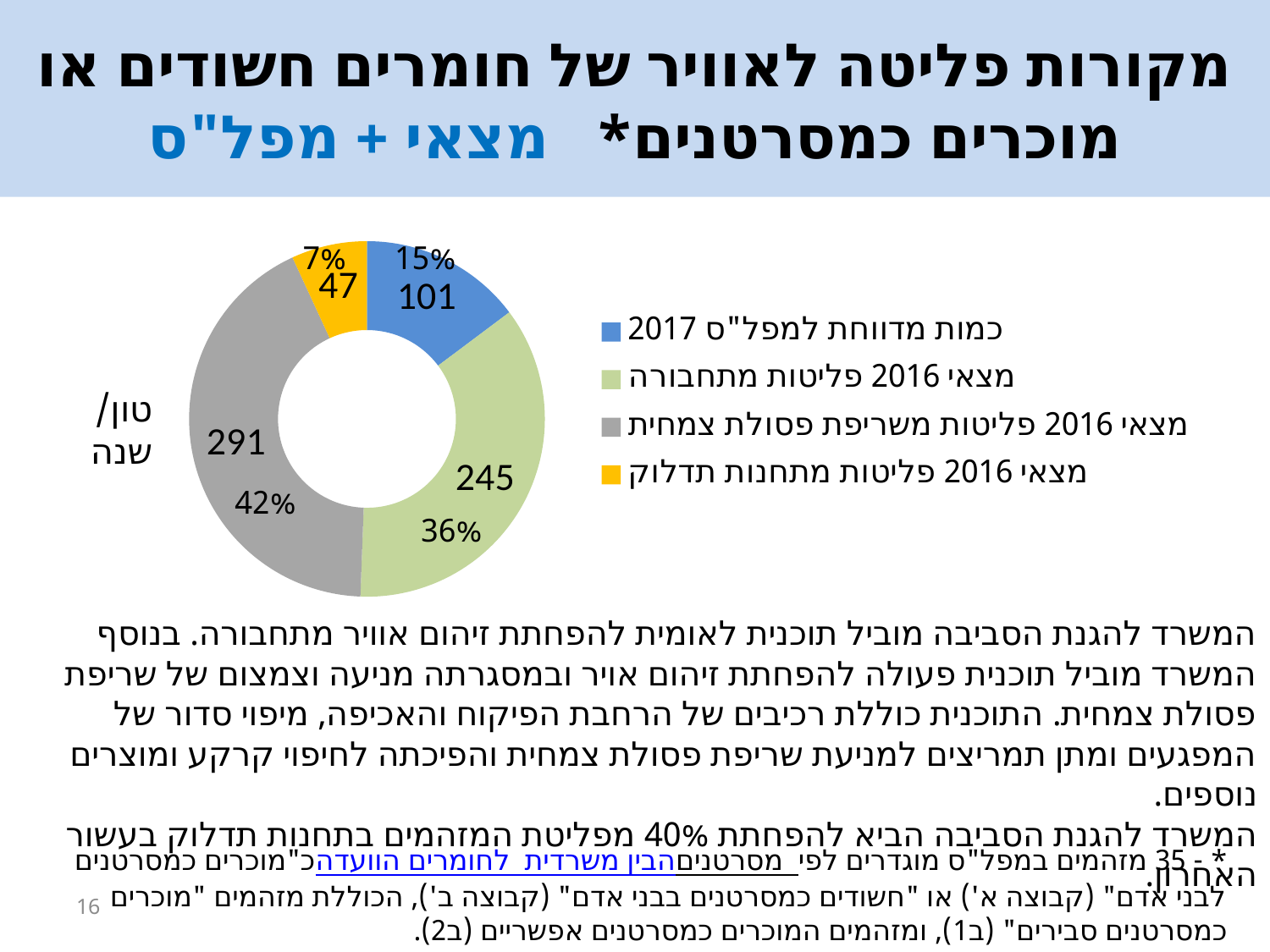
What kind of chart is shown on the slide? Pie (donut) chart Which is larger: the value for "כמות מדווחת למפל"ס 2017" or the value for "מצאי 2016 פליטות מתחנות תדלוק"? כמות מדווחת למפל"ס 2017 What percentage share does the slice "מצאי 2016 פליטות מתחנות תדלוק" have? 7% What value is shown for the slice "מצאי 2016 פליטות משריפת פסולת צמחית"? 291 What is the difference between the values for "מצאי 2016 פליטות משריפת פסולת צמחית" and "מצאי 2016 פליטות מתחבורה"? 46 What value is shown for the slice "מצאי 2016 פליטות מתחנות תדלוק"? 47 Which slice of the chart is the largest? מצאי 2016 פליטות משריפת פסולת צמחית What value is shown for the slice "כמות מדווחת למפל"ס 2017"? 101 Which slice of the chart is the smallest? מצאי 2016 פליטות מתחנות תדלוק What unit is indicated next to the chart? טון/שנה How many slices does the chart have? 4 What percentage share does the slice "מצאי 2016 פליטות מתחבורה" have? 36%